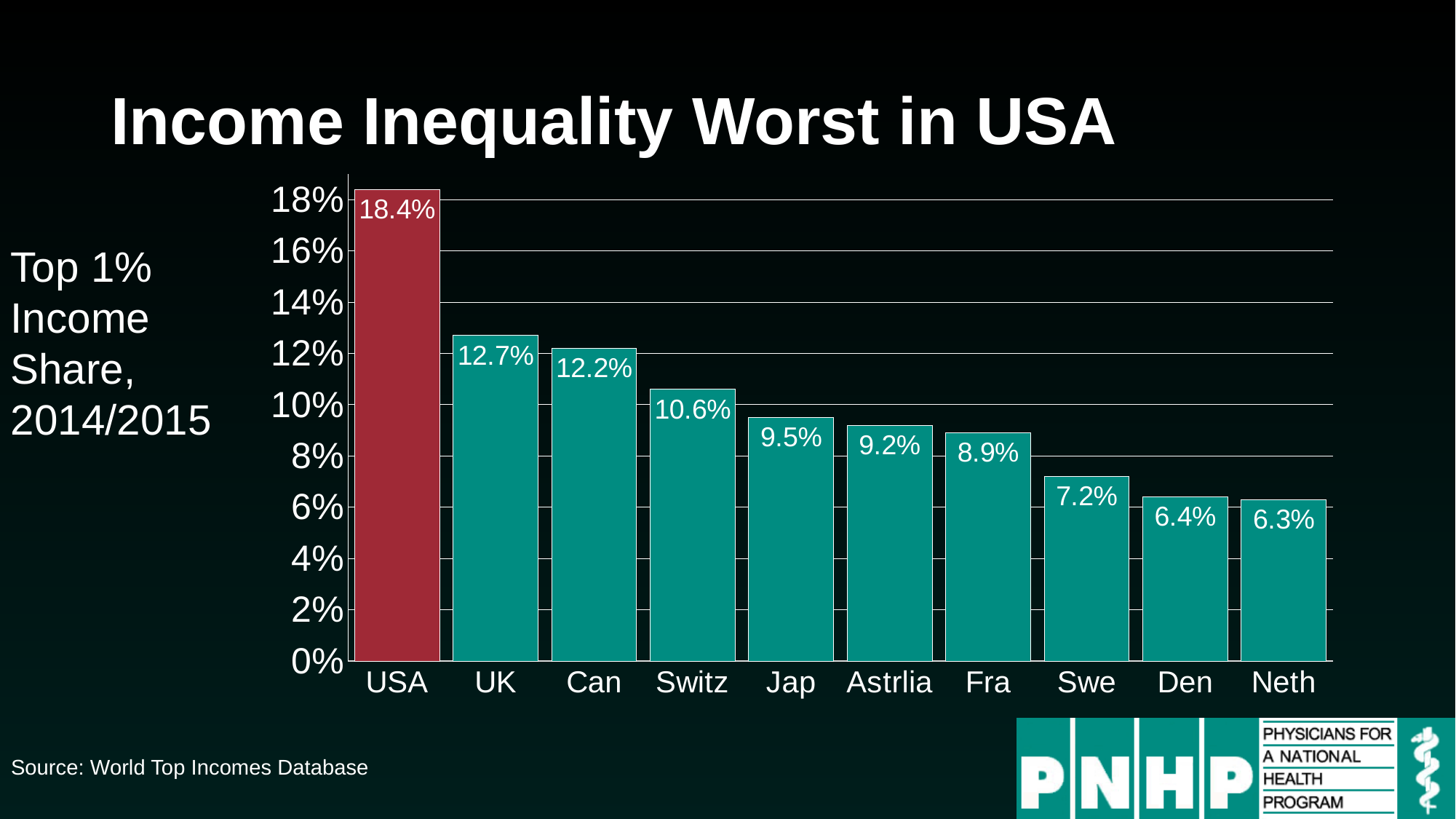
How many countries are shown on the chart? 10 What is the difference between the values for Can and Den? 5.8% What is the difference between the values for USA and UK? 5.7% Which is larger, the value for Jap or the value for Fra? Jap What is the value shown for Swe? 7.2% Do the values rise or fall from left to right along the x axis? fall What is the top 1% income share for the USA? 18.4% What is the value shown for Switz? 10.6% Is the value for Astrlia greater or less than 10%? less What kind of chart is shown on the slide? bar chart Which country has the lowest top 1% income share? Neth Which country has the highest top 1% income share? USA